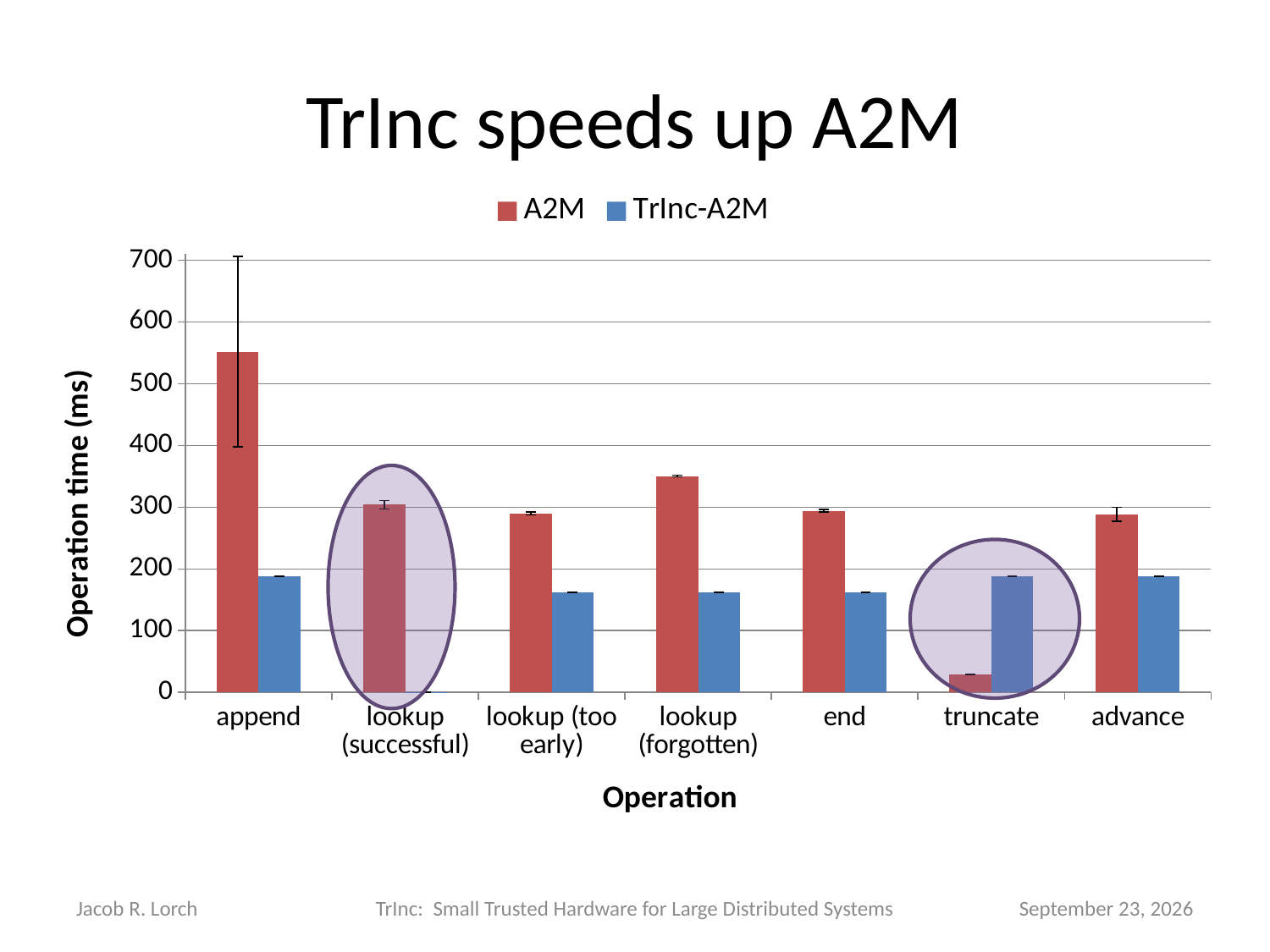
What is the label of the y axis? Operation time (ms) Is the A2M value for lookup (forgotten) greater or less than 300? greater Which operation has the highest A2M operation time? append Which operation has the lowest TrInc-A2M operation time? lookup (successful) How many operations are shown on the x axis? 7 For the truncate operation, which is larger: A2M or TrInc-A2M? TrInc-A2M What kind of chart is shown on the slide? bar chart Which operation has the lowest A2M operation time? truncate Is the A2M value for append greater or less than 500? greater Is the TrInc-A2M value for append greater or less than 200? less How many series does the legend list? 2